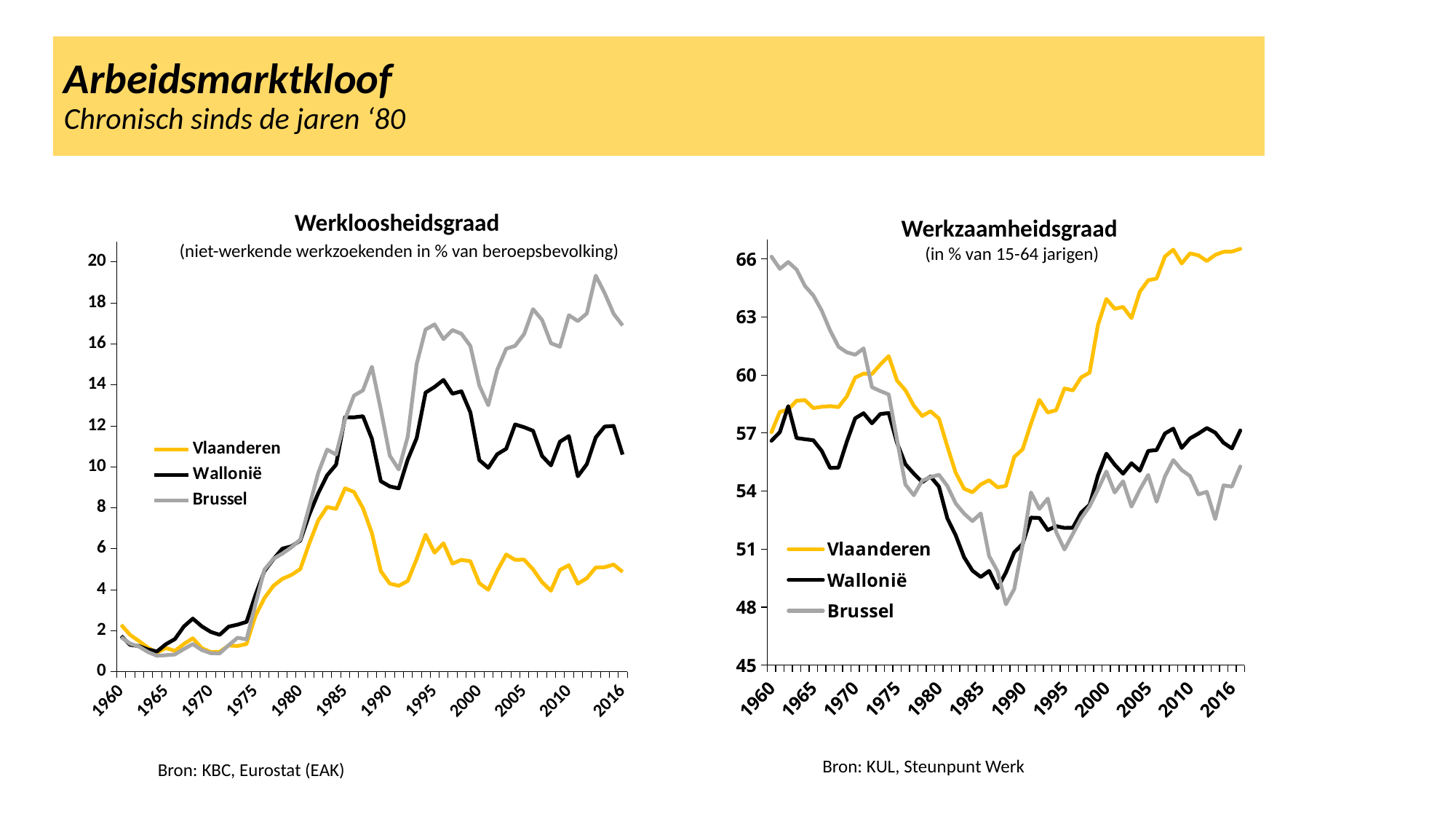
What is the subtitle shown under the title of the 'Werkzaamheidsgraad' chart? (in % van 15-64 jarigen) In the 'Werkzaamheidsgraad' chart, is the value for Brussel around 1988 greater or less than 51? less What kind of chart is the 'Werkloosheidsgraad' chart on the left? line chart In the 'Werkloosheidsgraad' chart, which series are listed in the legend? Vlaanderen, Wallonië, Brussel How many series does the legend of the 'Werkzaamheidsgraad' chart list? 3 In the 'Werkzaamheidsgraad' chart, which series has the higher value in 2016, Vlaanderen or Brussel? Vlaanderen In the 'Werkzaamheidsgraad' chart, does the Vlaanderen line rise or fall between 1990 and 2016? rise In the 'Werkloosheidsgraad' chart, which series has the higher value in 2016, Brussel or Vlaanderen? Brussel In the 'Werkloosheidsgraad' chart, is the value for Vlaanderen in 2016 greater or less than 6? less In the 'Werkzaamheidsgraad' chart, is the value for Vlaanderen in 2016 greater or less than 63? greater In the 'Werkloosheidsgraad' chart, does the Vlaanderen line rise or fall between 1975 and 1985? rise